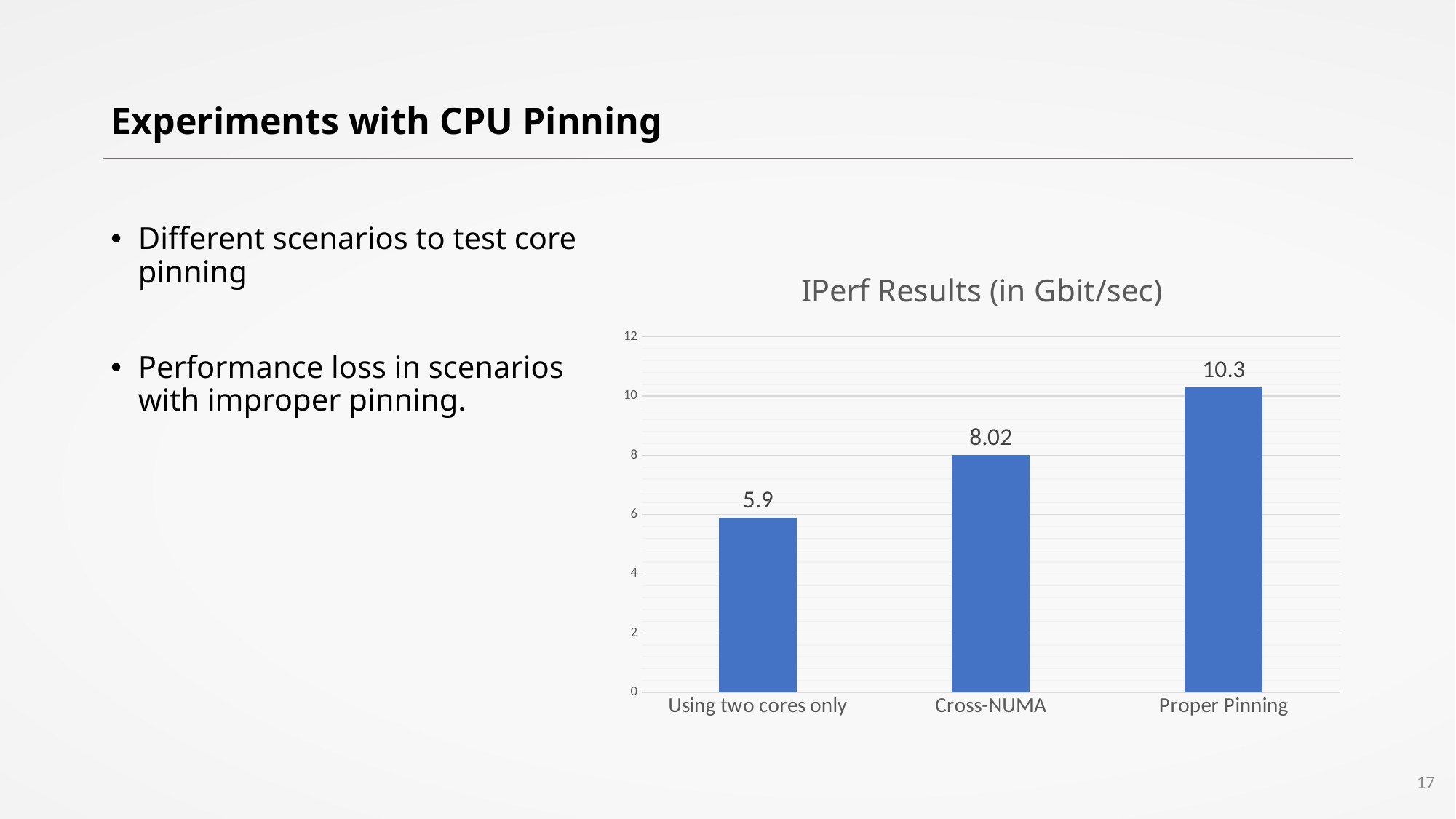
What is the difference between the IPerf results for Cross-NUMA and Using two cores only? 2.12 Which has a higher IPerf result, Cross-NUMA or Using two cores only? Cross-NUMA What kind of chart is shown on the slide? bar chart Which scenario has the highest IPerf result? Proper Pinning What is the difference between the IPerf results for Proper Pinning and Cross-NUMA? 2.28 What is the IPerf result for Proper Pinning? 10.3 Is the value for Proper Pinning greater or less than 10? greater Which scenario has the lowest IPerf result? Using two cores only What is the IPerf result for Cross-NUMA? 8.02 How many scenarios are shown in the chart? 3 What is the title of the chart? IPerf Results (in Gbit/sec) What is the IPerf result for Using two cores only? 5.9